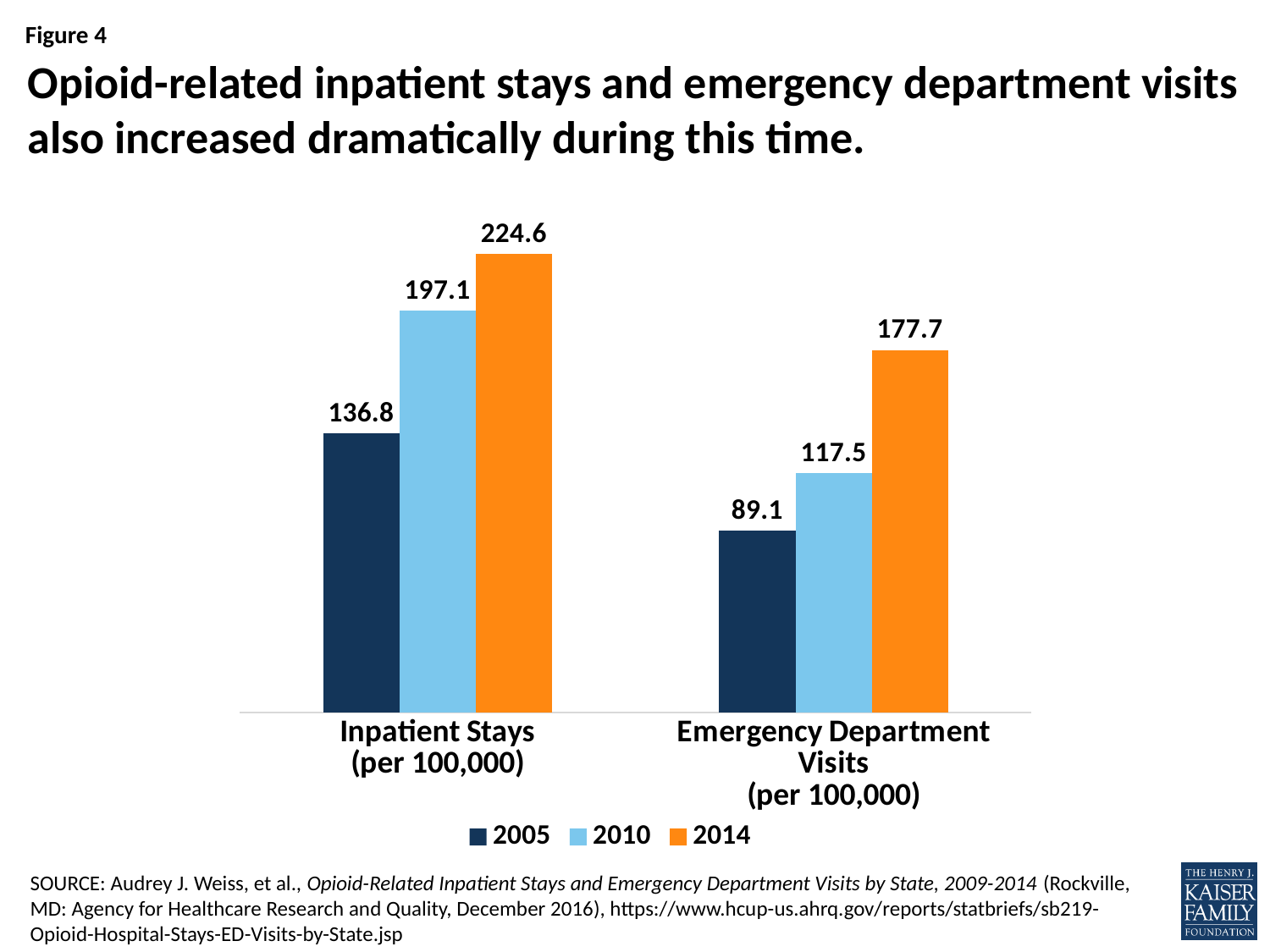
Do the values for Inpatient Stays (per 100,000) rise or fall from 2005 to 2014? Rise What is the difference between the 2014 and 2005 values for Inpatient Stays (per 100,000)? 87.8 How many series does the legend list? 3 Which year has the highest value for Emergency Department Visits (per 100,000)? 2014 What is the difference between the 2014 and 2010 values for Emergency Department Visits (per 100,000)? 60.2 What kind of chart is shown on the slide? Bar chart What is the value for Inpatient Stays (per 100,000) in 2014? 224.6 Which is larger: Inpatient Stays in 2005 or Emergency Department Visits in 2010? Inpatient Stays in 2005 What is the value for Emergency Department Visits (per 100,000) in 2010? 117.5 What is the value for Inpatient Stays (per 100,000) in 2010? 197.1 Which year has the lowest value for Inpatient Stays (per 100,000)? 2005 What is the value for Emergency Department Visits (per 100,000) in 2005? 89.1